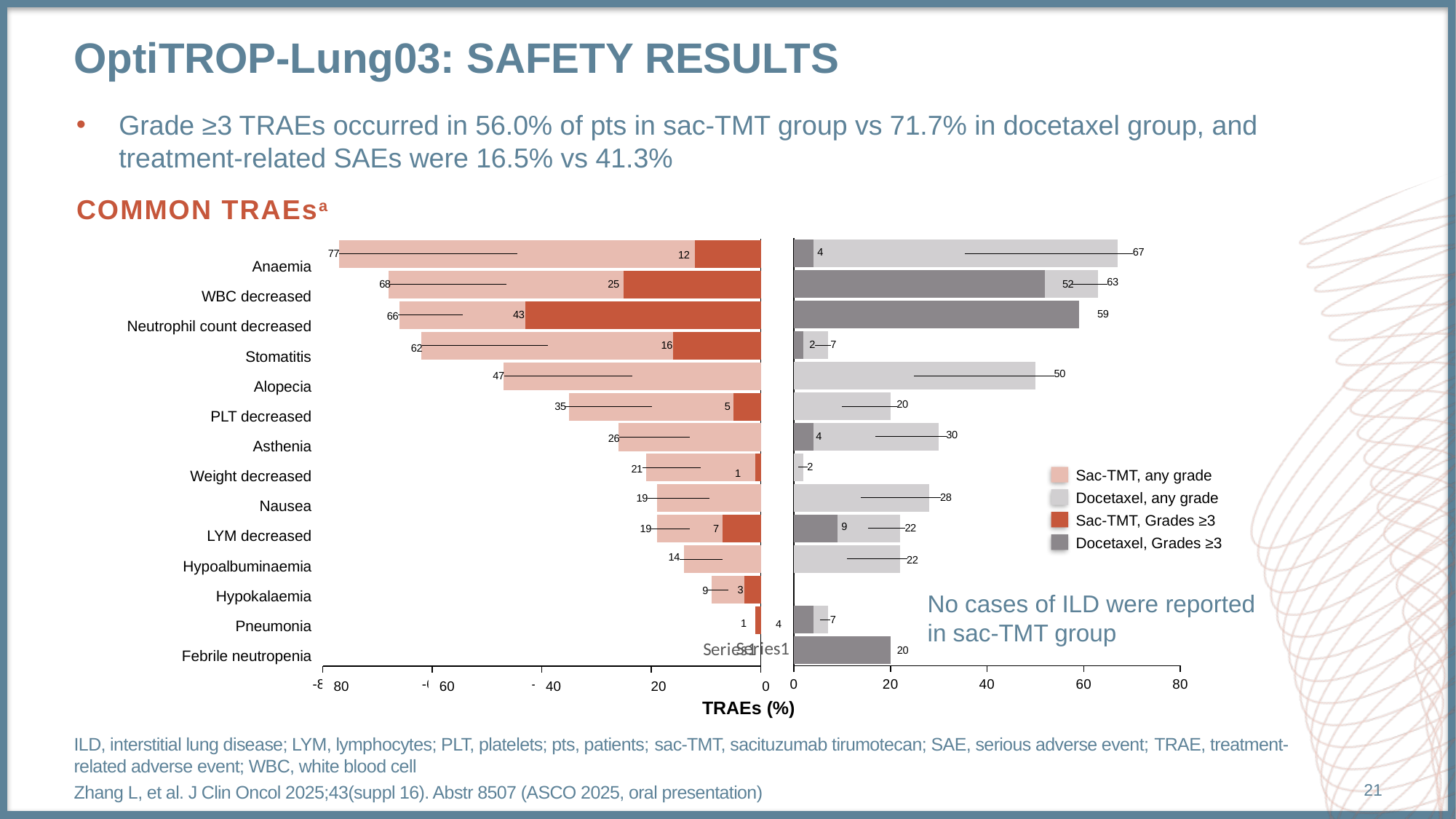
How many TRAE categories are listed on the chart? 14 Which TRAE has the highest sac-TMT grade ≥3 rate? Neutrophil count decreased What is the sac-TMT grade ≥3 rate for neutrophil count decreased? 43 How many series does the legend list? 4 What is the sac-TMT any-grade rate for anaemia? 77 What is the difference between the docetaxel any-grade rate and the sac-TMT any-grade rate for alopecia? 3 What is the docetaxel grade ≥3 rate for WBC decreased? 52 What is the docetaxel any-grade rate for alopecia? 50 Which is larger for stomatitis: the sac-TMT any-grade rate or the docetaxel any-grade rate? Sac-TMT any grade What is the label of the x axis? TRAEs (%) Which TRAE has the highest sac-TMT any-grade rate? Anaemia What kind of chart is shown? Bar chart